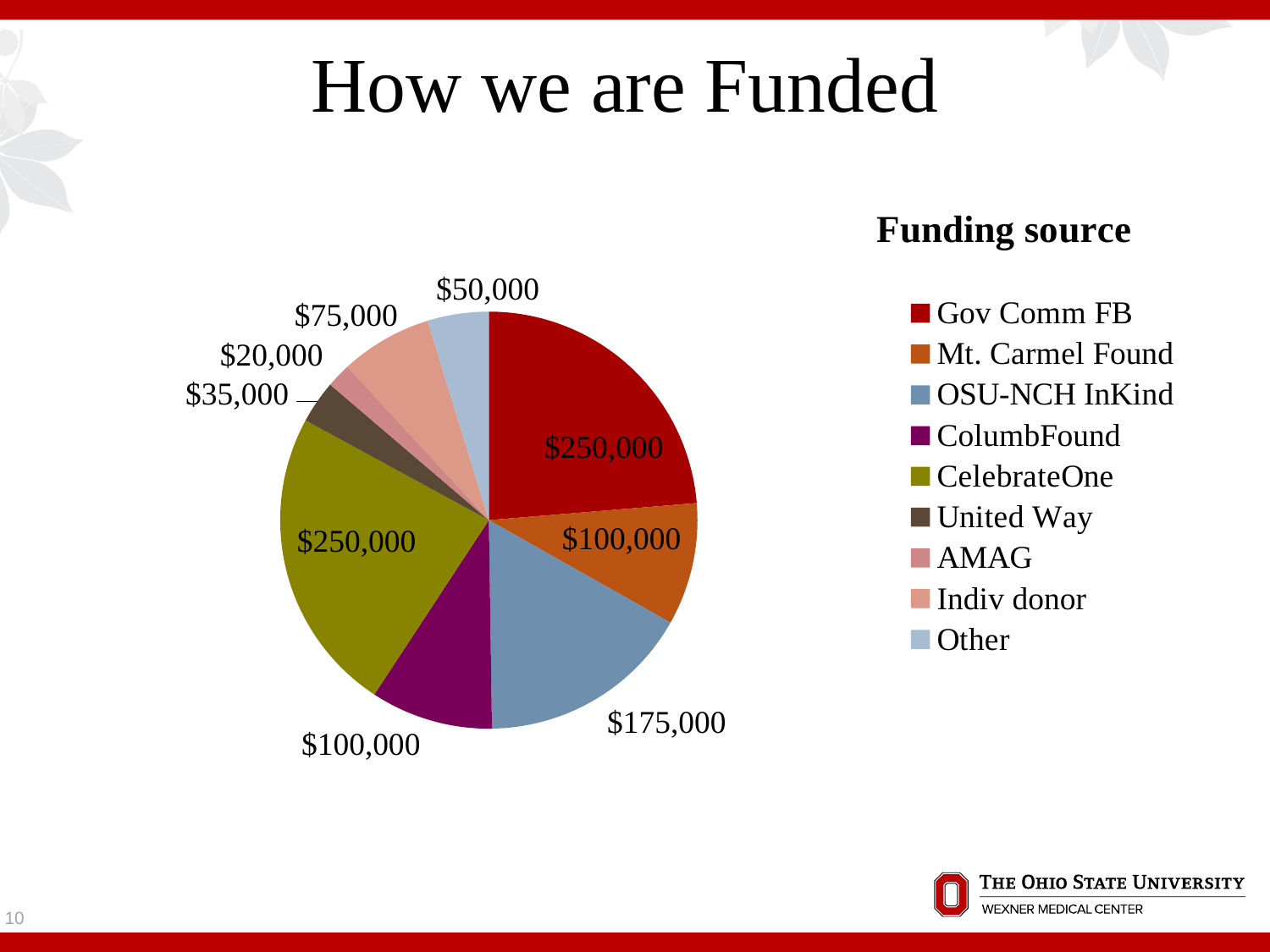
What kind of chart is shown on the slide? pie chart What is the value for United Way? $35,000 Which is larger, the Indiv donor slice or the Other slice? Indiv donor What is the value for Gov Comm FB? $250,000 What is the total of all the slices in the pie chart? $1,055,000 What is the title shown above the legend? Funding source What is the difference between the CelebrateOne value and the ColumbFound value? $150,000 Which funding source has the smallest slice? AMAG How many funding sources are shown in the pie chart? 9 What is the difference between the OSU-NCH InKind value and the Mt. Carmel Found value? $75,000 What is the value for OSU-NCH InKind? $175,000 What is the value for Indiv donor? $75,000